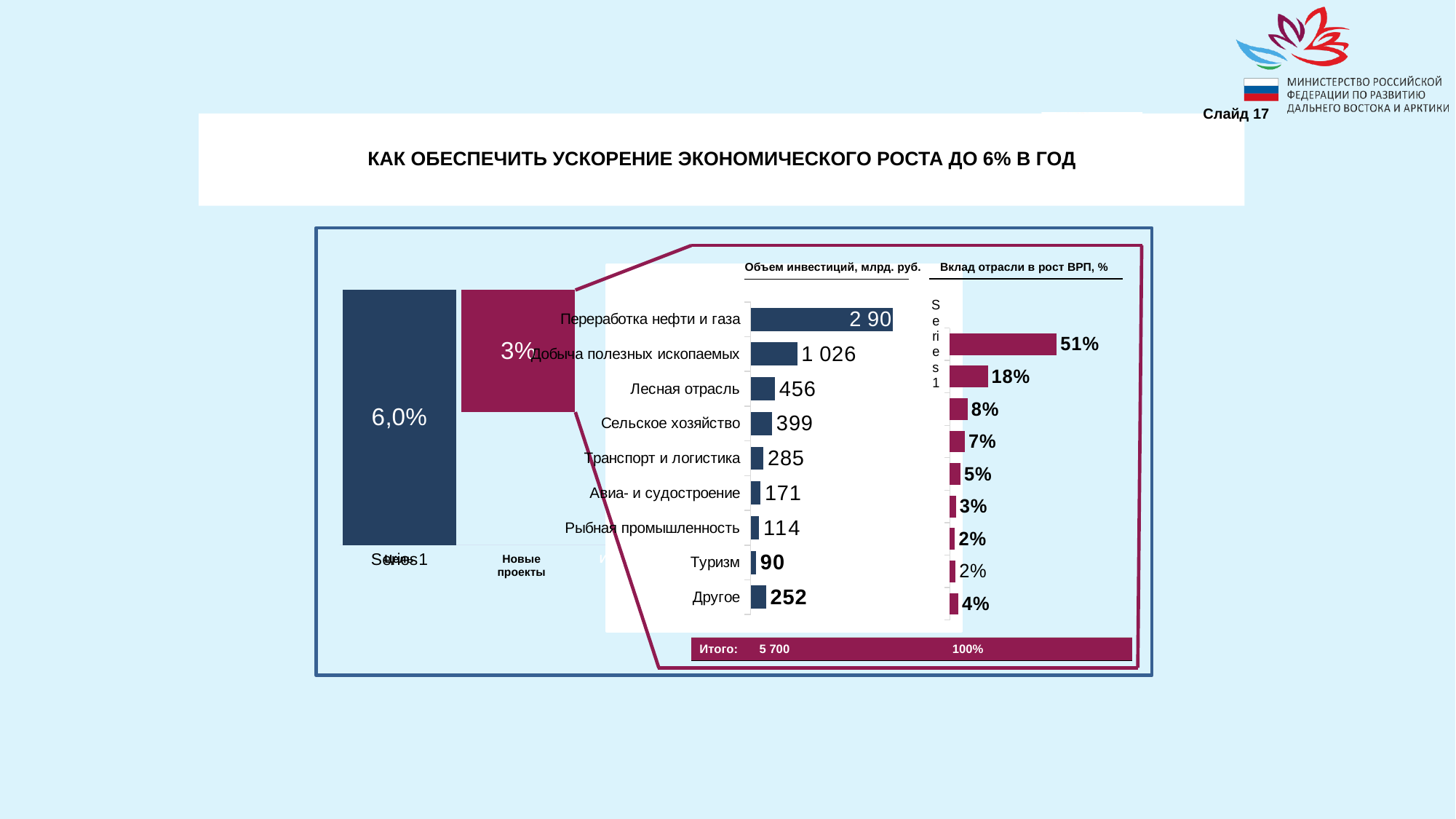
How many categories are shown in the 'Объем инвестиций, млрд. руб.' chart? 9 In the 'Объем инвестиций, млрд. руб.' chart, which is larger: Транспорт и логистика or Другое? Транспорт и логистика In the 'Вклад отрасли в рост ВРП, %' chart, what is the value for Переработка нефти и газа? 51% In the 'Вклад отрасли в рост ВРП, %' chart, what is the value for Сельское хозяйство? 7% In the 'Объем инвестиций, млрд. руб.' chart, what is the difference between Добыча полезных ископаемых and Лесная отрасль? 570 In the 'Объем инвестиций, млрд. руб.' chart, which category has the largest bar? Переработка нефти и газа What kind of chart is the 'Вклад отрасли в рост ВРП, %' chart? Bar chart In the 'Объем инвестиций, млрд. руб.' chart, what is the value for Лесная отрасль? 456 In the 'Объем инвестиций, млрд. руб.' chart, what is the value for Туризм? 90 In the 'Объем инвестиций, млрд. руб.' chart, what is the value for Добыча полезных ископаемых? 1 026 In the 'Вклад отрасли в рост ВРП, %' chart, what is the difference between Переработка нефти и газа and Добыча полезных ископаемых? 33% In the 'Объем инвестиций, млрд. руб.' chart, which category has the smallest value? Туризм